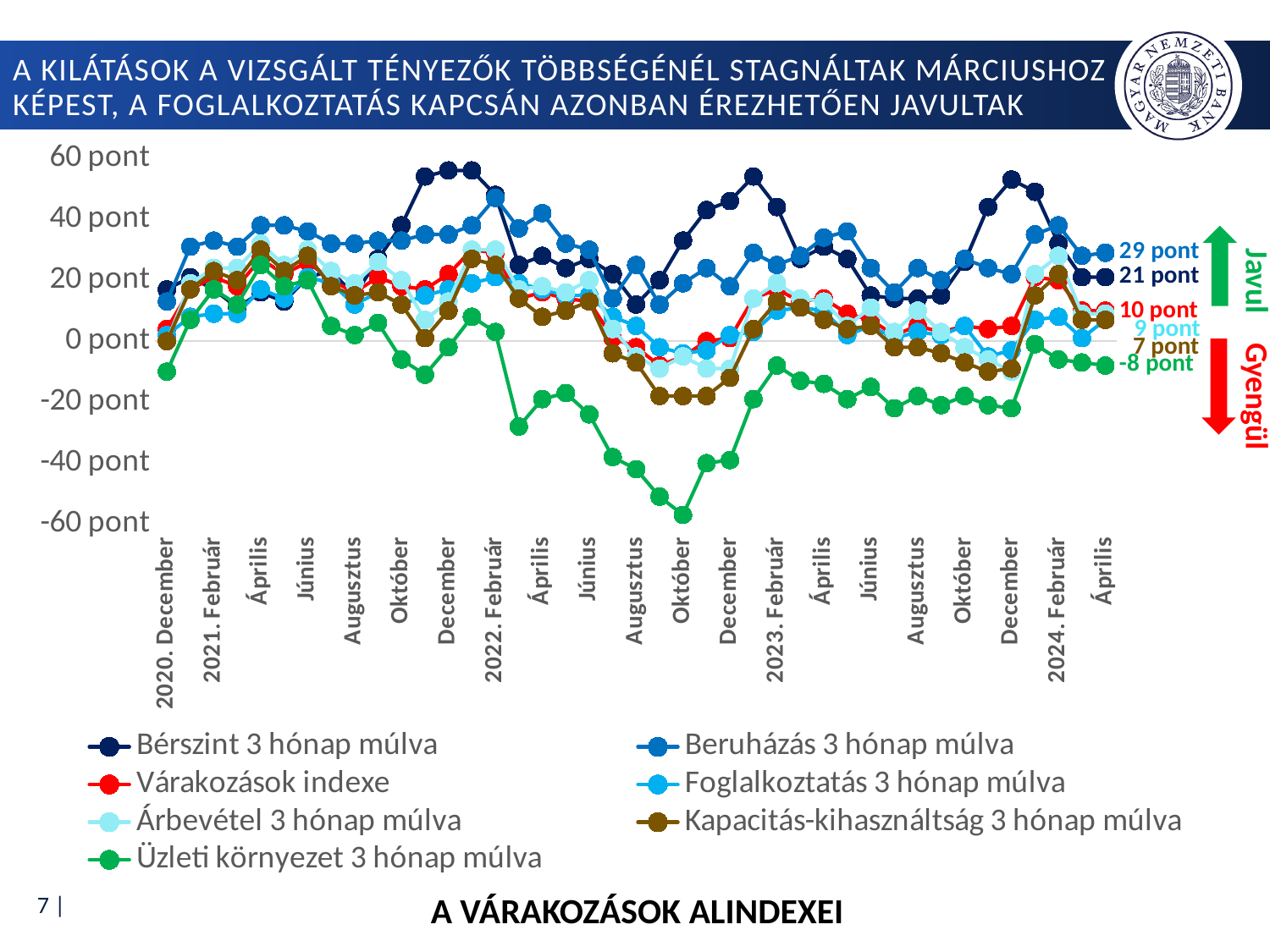
How many series does the legend list? 7 What is the final labelled value for Várakozások indexe? 10 pont What is the difference between the final labelled values of Beruházás 3 hónap múlva (29 pont) and Bérszint 3 hónap múlva (21 pont)? 8 pont What is the final labelled value for Üzleti környezet 3 hónap múlva? -8 pont Is the value for Üzleti környezet 3 hónap múlva in October 2022 greater or less than -40 pont? less What is the final labelled value for Beruházás 3 hónap múlva? 29 pont What is the final labelled value for Bérszint 3 hónap múlva? 21 pont Which series has the highest labelled value at the end of the chart (2024 April)? Beruházás 3 hónap múlva What kind of chart is shown on the slide? line chart What is the title of the chart shown at the bottom of the slide? A VÁRAKOZÁSOK ALINDEXEI Does the Üzleti környezet 3 hónap múlva series rise or fall between February 2022 and October 2022? fall Which series has the lowest labelled value at the end of the chart (2024 April)? Üzleti környezet 3 hónap múlva